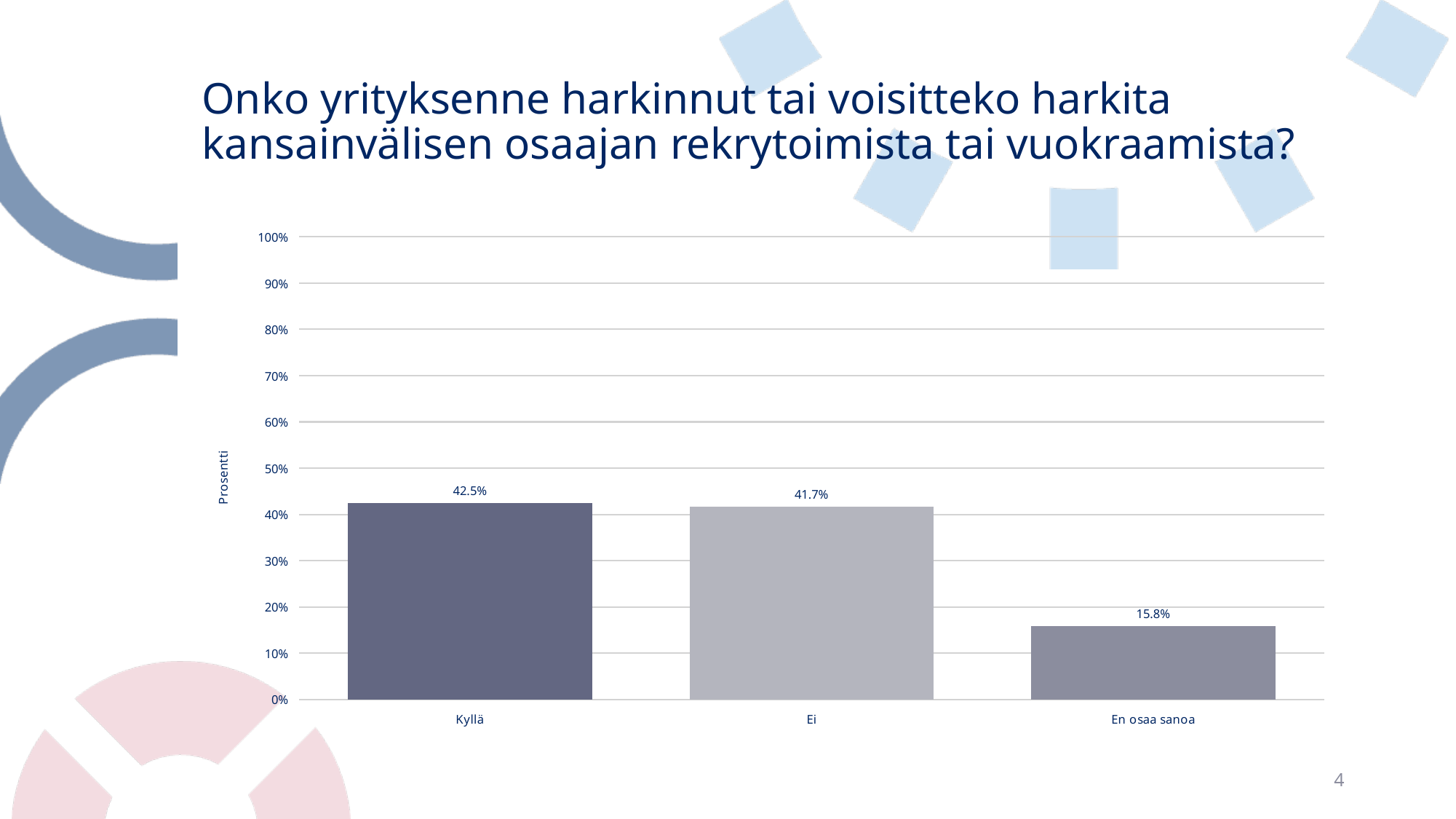
What is the difference between the values for Kyllä and Ei? 0.8% What is the label of the vertical axis? Prosentti What kind of chart is shown on the slide? bar chart How many categories are shown on the x axis? 3 Which is larger, the value for Kyllä or the value for En osaa sanoa? Kyllä What is the value for Ei? 41.7% What is the highest value shown on the vertical axis? 100% Which category has the lowest value? En osaa sanoa What is the value for En osaa sanoa? 15.8% What is the difference between the values for Ei and En osaa sanoa? 25.9% What is the value for Kyllä? 42.5% Is the value for En osaa sanoa greater or less than 20%? less